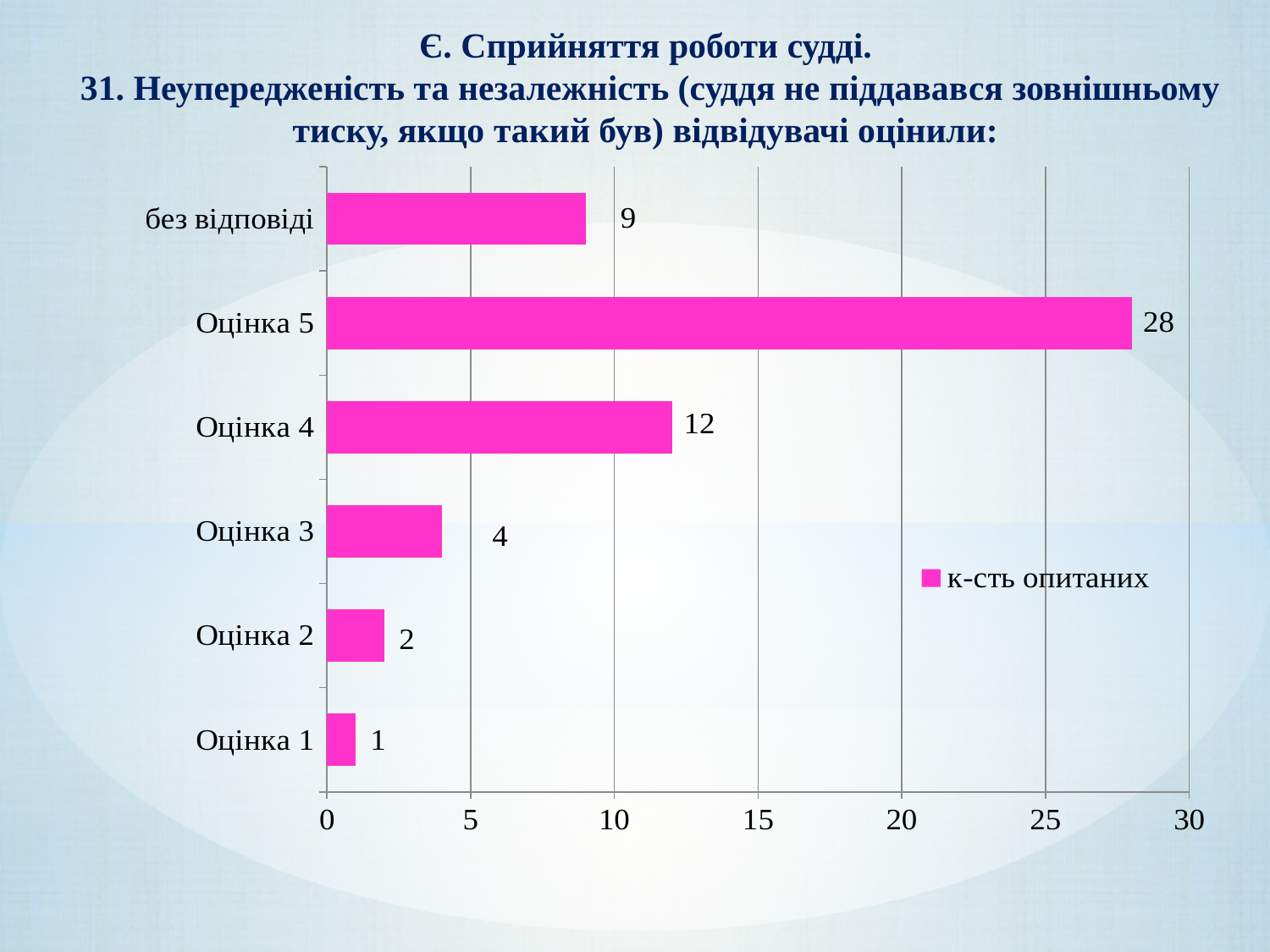
Which category has the lowest value? Оцінка 1 How many categories are shown on the chart? 6 What is the value for Оцінка 3? 4 How many series does the legend list? 1 What is the value for без відповіді? 9 What is the legend entry for the series? к-сть опитаних What is the value for Оцінка 5? 28 What is the difference between the values for Оцінка 5 and Оцінка 4? 16 What kind of chart is shown on the slide? bar chart Which category has the highest value? Оцінка 5 Is the value for Оцінка 5 greater or less than 25? greater Which is larger, the value for Оцінка 4 or the value for без відповіді? Оцінка 4